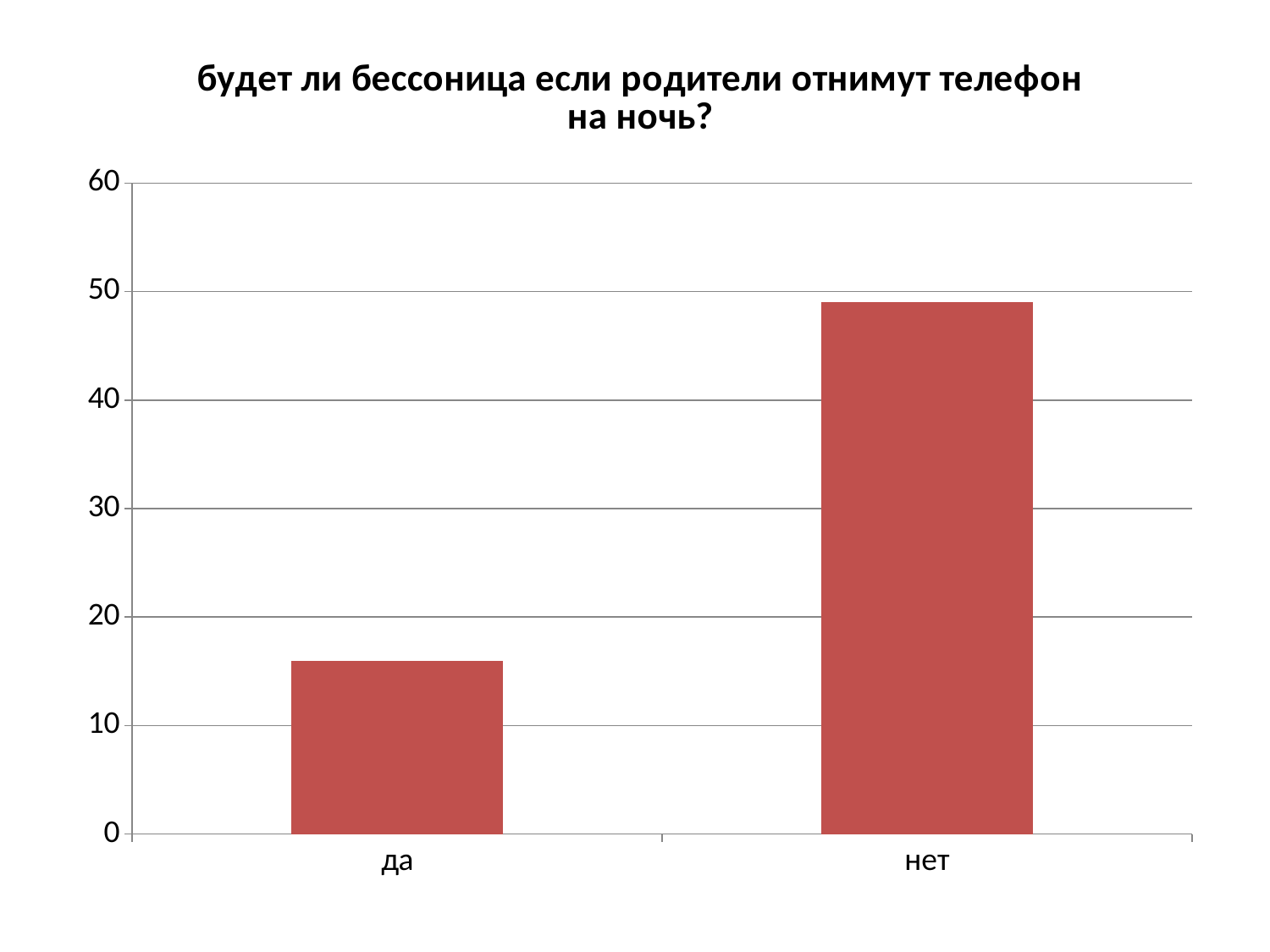
Which category has the lowest bar in the chart? да What kind of chart is shown on the slide? bar chart Is the value for "нет" greater or less than 40? greater Is the value for "да" greater or less than 20? less Which is larger, the value for "да" or the value for "нет"? нет How many categories are shown on the x axis of the chart? 2 What is the highest value shown on the vertical axis of the chart? 60 Which category has the highest bar in the chart? нет Is the value for "да" greater or less than 10? greater Do the bar values rise or fall from left to right along the x axis? rise What is the title of the chart? будет ли бессоница если родители отнимут телефон на ночь?